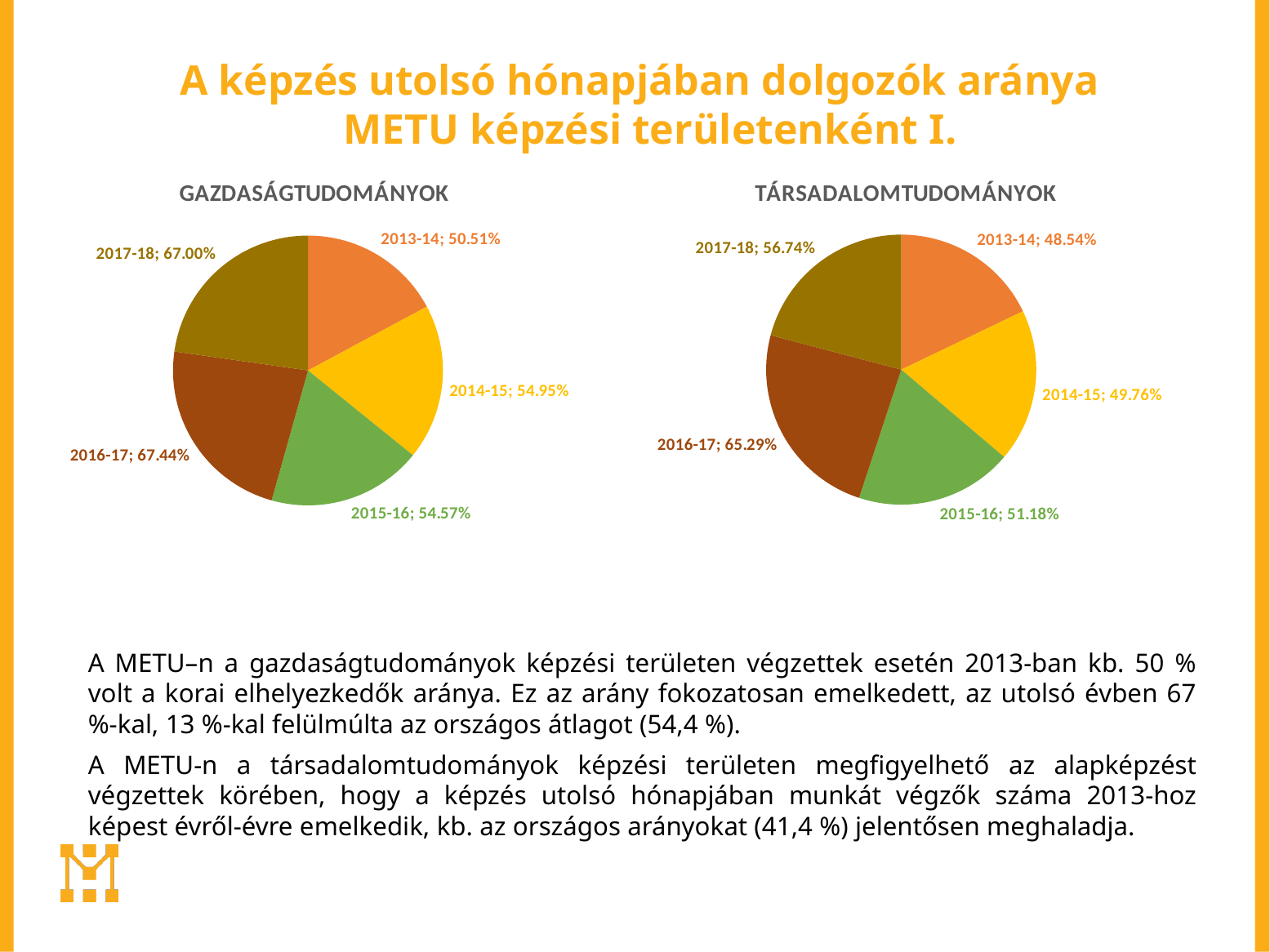
In the TÁRSADALOMTUDOMÁNYOK chart, what is the value for 2016-17? 65.29% How many slices does the GAZDASÁGTUDOMÁNYOK chart have? 5 In the GAZDASÁGTUDOMÁNYOK chart, what is the value for 2017-18? 67.00% What is the title of the chart on the left of the slide? GAZDASÁGTUDOMÁNYOK In the GAZDASÁGTUDOMÁNYOK chart, what is the value for 2013-14? 50.51% In the GAZDASÁGTUDOMÁNYOK chart, what is the difference between the values for 2016-17 and 2013-14? 16.93% In the TÁRSADALOMTUDOMÁNYOK chart, which is larger, the value for 2017-18 or the value for 2015-16? 2017-18 In the GAZDASÁGTUDOMÁNYOK chart, which year has the highest value? 2016-17 In the TÁRSADALOMTUDOMÁNYOK chart, which year has the highest value? 2016-17 In the TÁRSADALOMTUDOMÁNYOK chart, which year has the lowest value? 2013-14 What kind of chart is the TÁRSADALOMTUDOMÁNYOK chart? Pie chart In the TÁRSADALOMTUDOMÁNYOK chart, what is the value for 2014-15? 49.76%